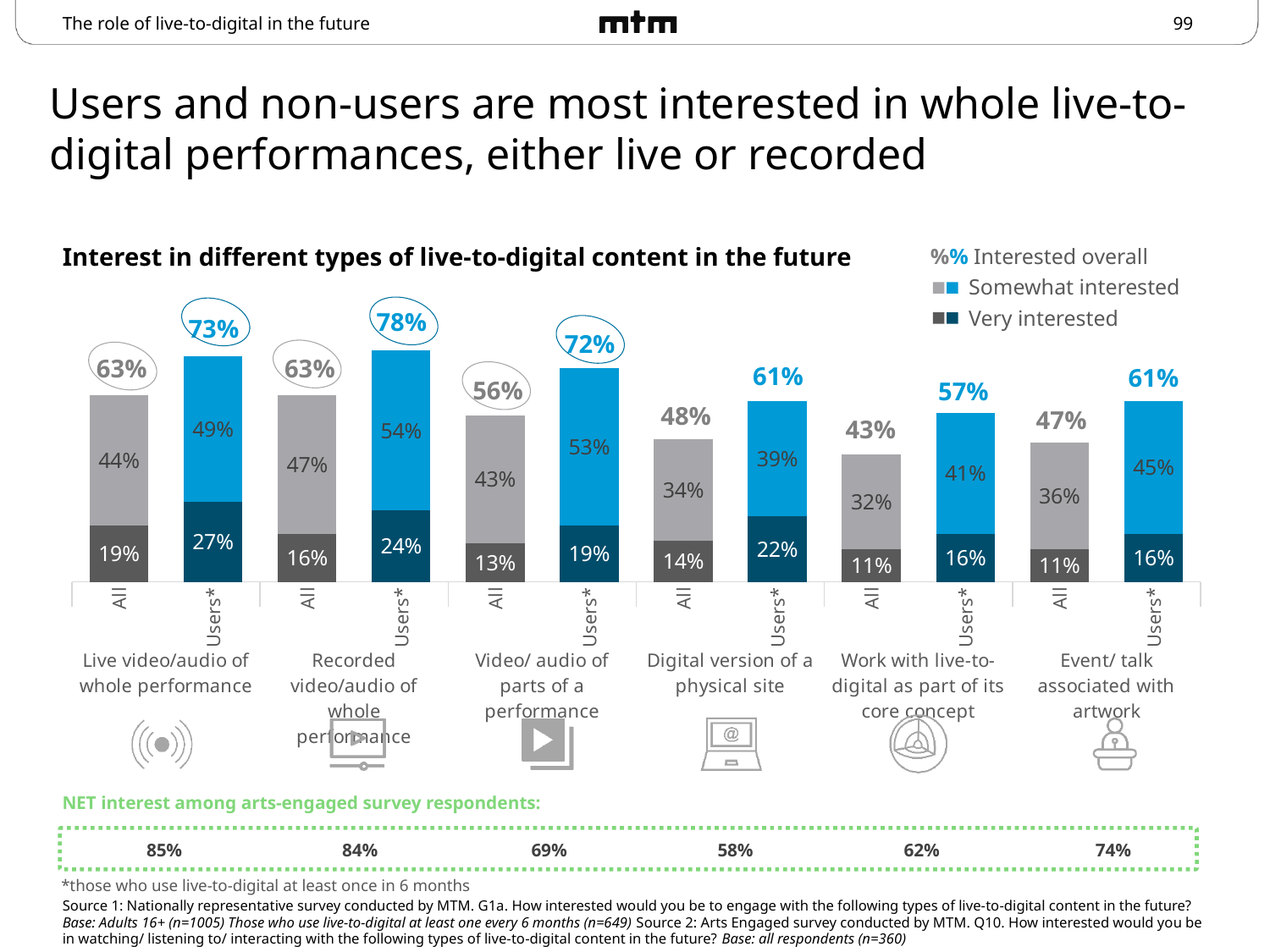
What is the total of the stacked bar for Users for work with live-to-digital as part of its core concept? 57% Which content type has the highest overall interest among Users? Recorded video/audio of whole performance Which is larger: the overall interest of All respondents for video/audio of parts of a performance or for a digital version of a physical site? Video/audio of parts of a performance How many content types are compared in the chart? 6 What is the overall interest percentage for Users for recorded video/audio of a whole performance? 78% What is the difference between the overall interest of Users and All respondents for live video/audio of a whole performance? 10 percentage points What is the NET interest among arts-engaged survey respondents for an event/talk associated with artwork? 74% What percentage of All respondents are very interested in a digital version of a physical site? 14% Which content type has the lowest overall interest among All respondents? Work with live-to-digital as part of its core concept What is the title of the chart? Interest in different types of live-to-digital content in the future What percentage of Users are somewhat interested in an event/talk associated with artwork? 45% What type of chart is shown on the slide? Stacked bar chart